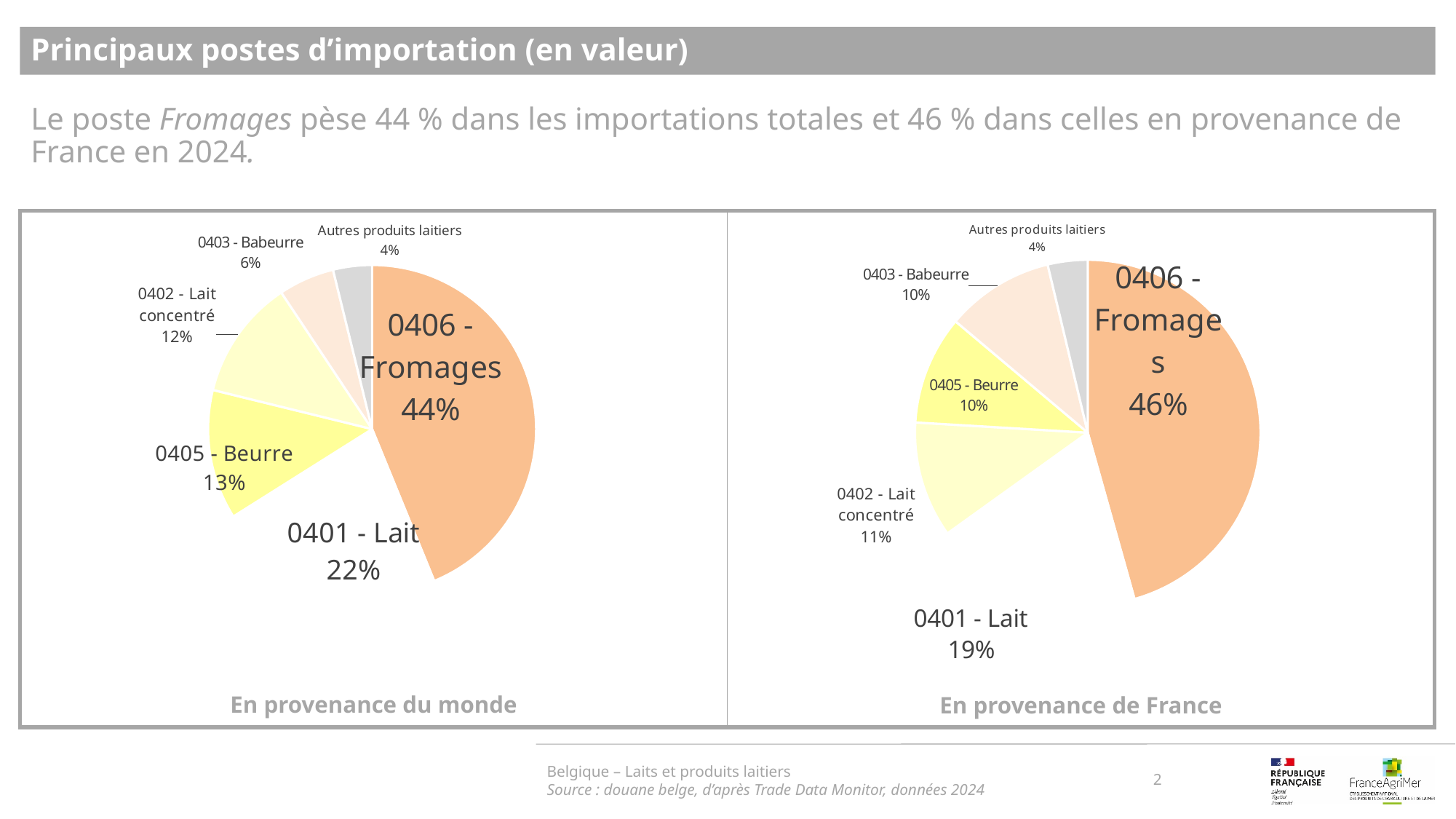
In the 'En provenance du monde' pie chart, what share does '0401 - Lait' have? 22% In the 'En provenance de France' pie chart, what share does '0402 - Lait concentré' have? 11% What is the title of the chart on the right side of the slide? En provenance de France In the 'En provenance de France' pie chart, what share does '0406 - Fromages' have? 46% What type of chart is used for 'En provenance du monde'? Pie chart In the 'En provenance du monde' pie chart, what share does '0406 - Fromages' have? 44% How many slices does the 'En provenance de France' pie chart have? 6 In the 'En provenance du monde' pie chart, which category has the smallest share? Autres produits laitiers In the 'En provenance de France' pie chart, which category has the largest share? 0406 - Fromages In the 'En provenance de France' pie chart, what is the difference in percentage points between '0406 - Fromages' and '0401 - Lait'? 27 percentage points In the 'En provenance du monde' pie chart, which is larger: '0402 - Lait concentré' or '0403 - Babeurre'? 0402 - Lait concentré In the 'En provenance du monde' pie chart, what is the difference in percentage points between '0401 - Lait' and '0405 - Beurre'? 9 percentage points